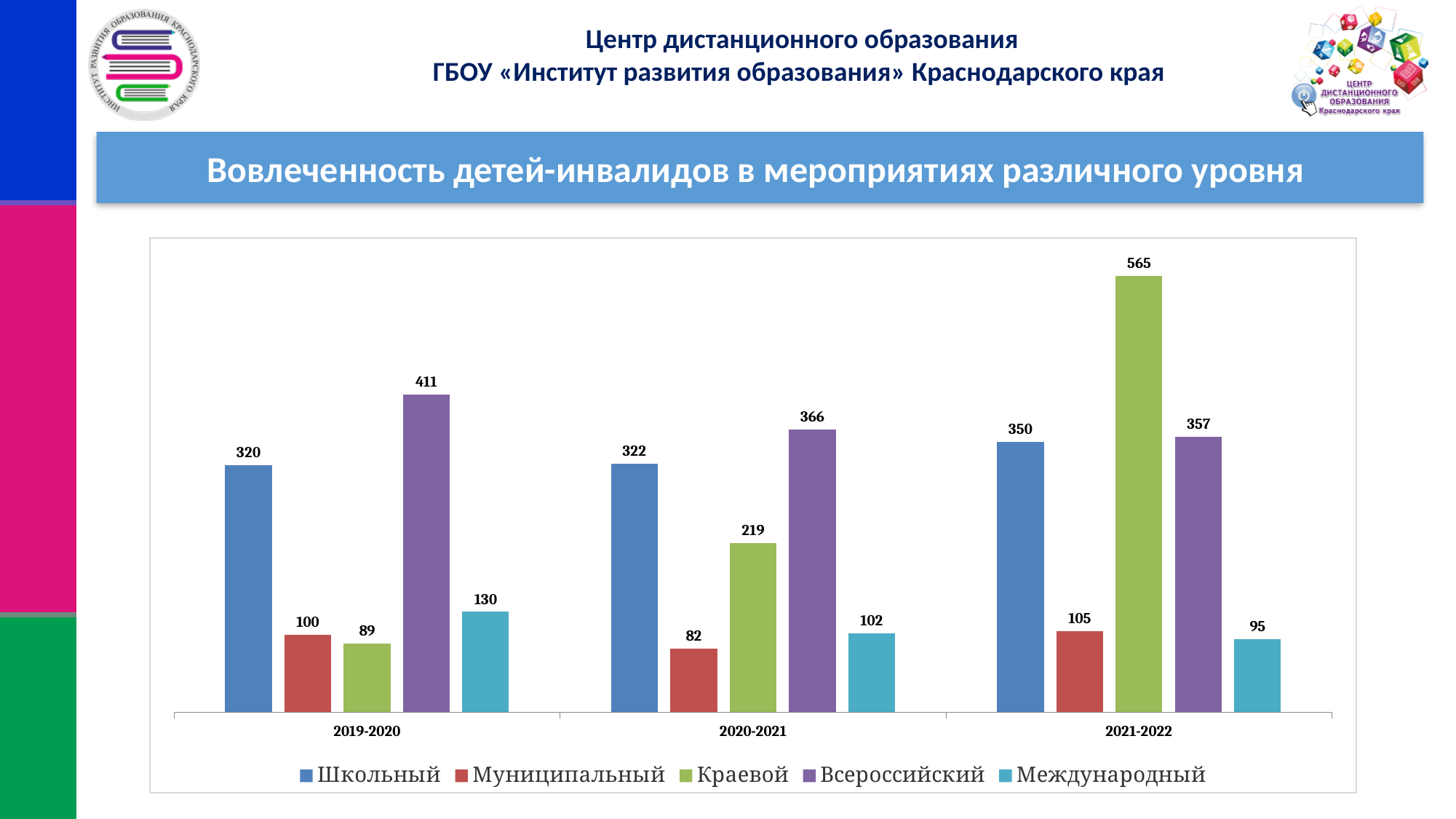
Which series has the lowest value in 2019-2020? Краевой Which series has the highest value in 2020-2021? Всероссийский Which is larger: Школьный in 2021-2022 or Всероссийский in 2021-2022? Всероссийский in 2021-2022 How many year categories are shown on the x axis? 3 Does the Школьный value rise or fall from 2019-2020 to 2021-2022? Rise What is the value for Краевой in 2021-2022? 565 What is the value for Международный in 2021-2022? 95 What is the value for Муниципальный in 2020-2021? 82 What kind of chart is shown on the slide? Bar chart What is the value for Всероссийский in 2019-2020? 411 What is the difference between the Краевой values for 2021-2022 and 2020-2021? 346 How many series does the legend list? 5